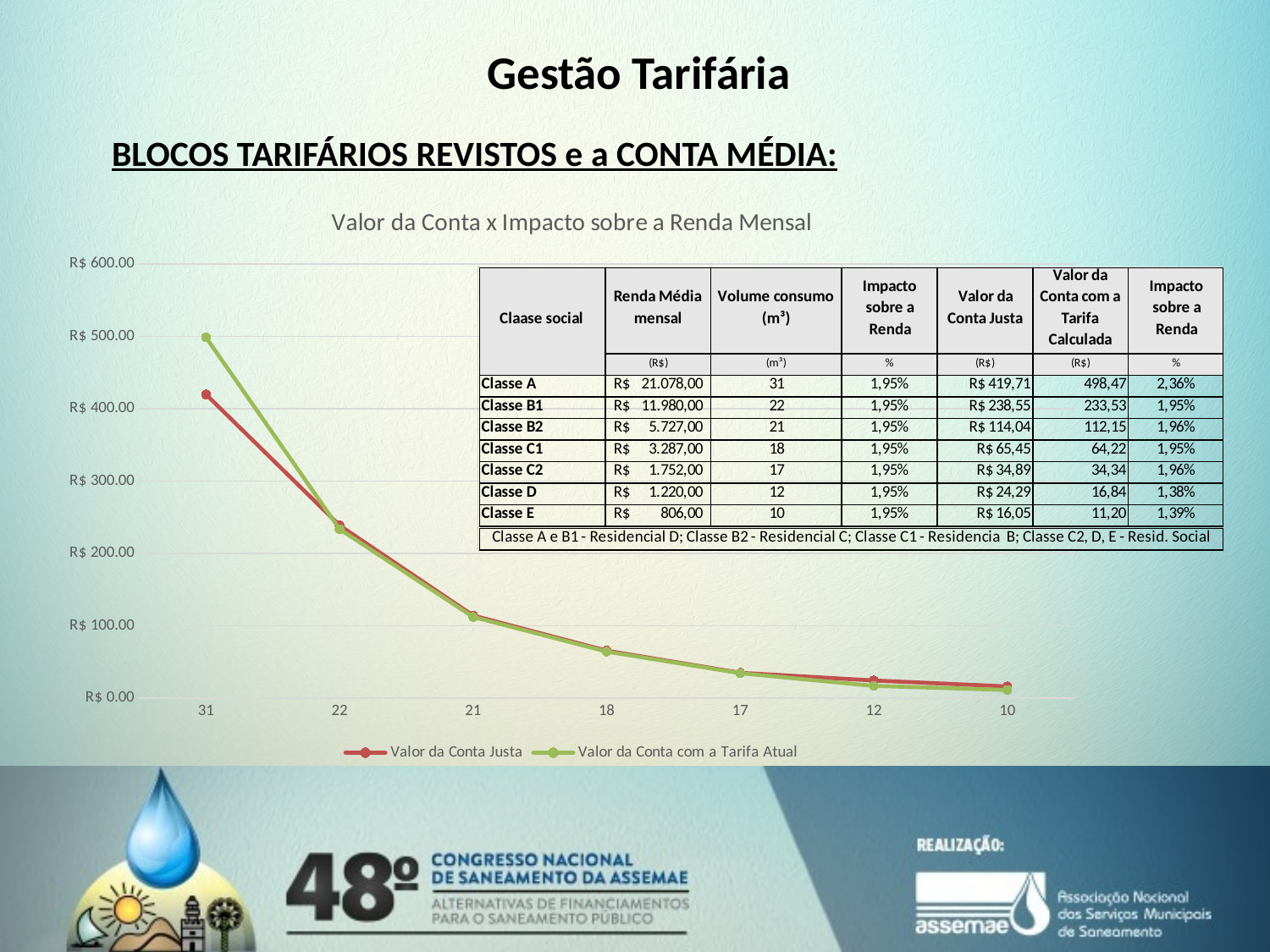
At x = 31, which series has the larger value, 'Valor da Conta Justa' or 'Valor da Conta com a Tarifa Atual'? Valor da Conta com a Tarifa Atual Is the value of 'Valor da Conta Justa' at x = 22 greater or less than R$ 300.00? less Do the values of the 'Valor da Conta Justa' series rise or fall moving from left to right along the x axis? fall Is the value of 'Valor da Conta com a Tarifa Atual' at x = 31 greater or less than R$ 400.00? greater Which series is drawn in red? Valor da Conta Justa Is the value of 'Valor da Conta Justa' at x = 18 greater or less than R$ 100.00? less How many series does the chart legend list? 2 What kind of chart is shown on the slide? line chart At which x-axis category does the 'Valor da Conta com a Tarifa Atual' series reach its highest value? 31 How many points are plotted along the x axis for each series? 7 What is the title of the chart? Valor da Conta x Impacto sobre a Renda Mensal At which x-axis category does the 'Valor da Conta Justa' series reach its lowest value? 10